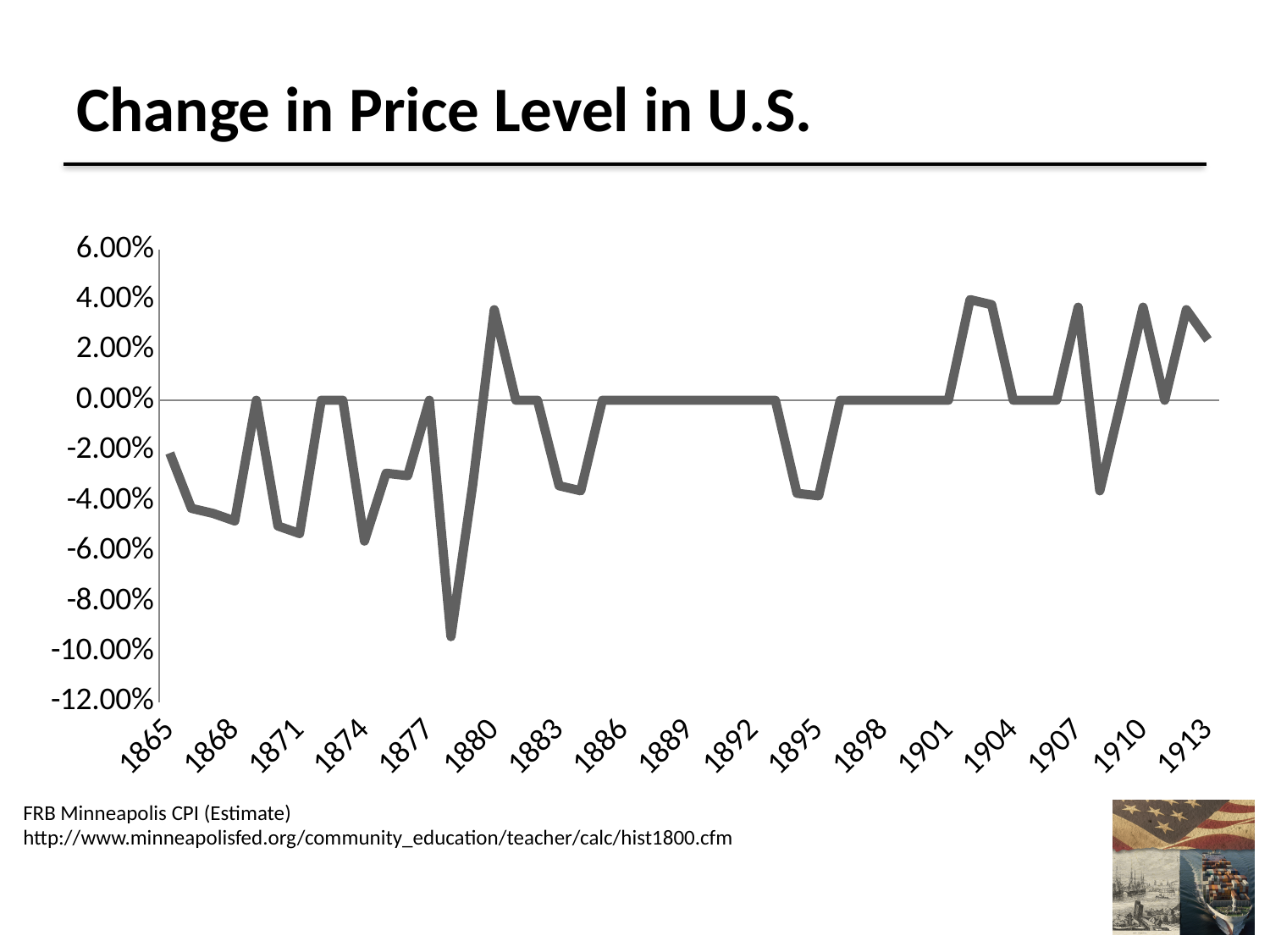
Is the value for 1913 greater or less than 0.00%? greater What is the title of the chart? Change in Price Level in U.S. Is the value for 1883 greater or less than -2.00%? less Which year has the higher value, 1880 or 1883? 1880 Which year has the higher value, 1865 or 1874? 1865 Is the value for 1865 greater or less than 0.00%? less What kind of chart is shown on the slide? line chart How many year labels are shown on the x axis? 17